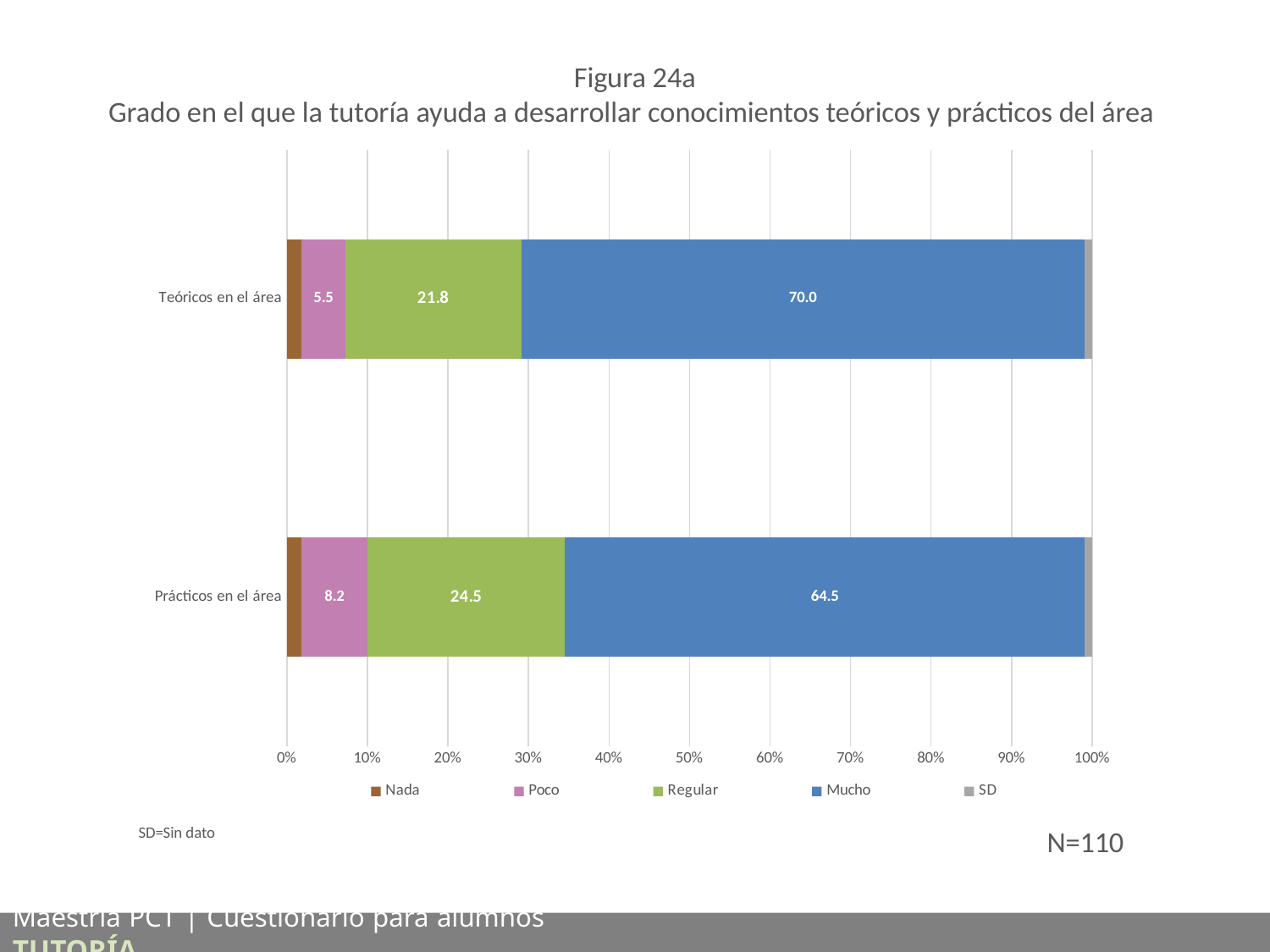
What kind of chart is shown on the slide? Stacked bar chart What is the difference between the Regular values for Prácticos en el área and Teóricos en el área? 2.7 What is the value for Poco in the Teóricos en el área bar? 5.5 How many series does the legend list? 5 Which category has the lower value for Poco? Teóricos en el área Which category has the higher value for Mucho, Teóricos en el área or Prácticos en el área? Teóricos en el área What is the value for Regular in the Prácticos en el área bar? 24.5 What is the difference between the Mucho values for Teóricos en el área and Prácticos en el área? 5.5 How many categories are shown on the chart? 2 What is the value for Mucho in the Prácticos en el área bar? 64.5 What does SD stand for according to the note below the chart? Sin dato What is the value for Mucho in the Teóricos en el área bar? 70.0